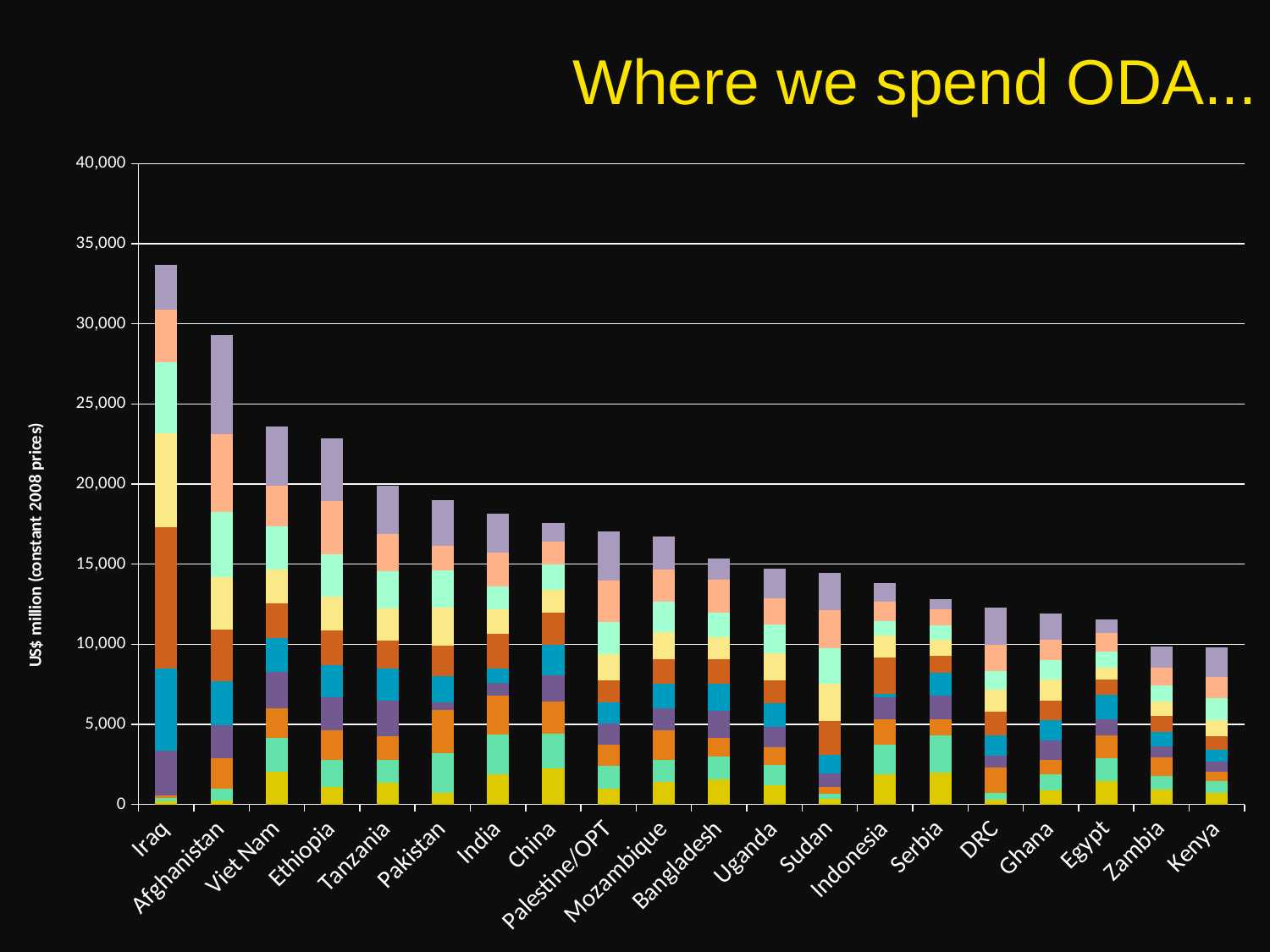
Do the total bar heights rise or fall moving from left to right along the x axis? Fall What is the title of the slide's chart? Where we spend ODA... What kind of chart is shown on the slide? Stacked bar chart Is the total value for Viet Nam greater or less than 20,000? greater Is the total value for Iraq greater or less than 30,000? greater Which has the larger total bar, Ethiopia or Tanzania? Ethiopia Is the total value for China greater or less than 15,000? greater Which has the larger total bar, Afghanistan or Viet Nam? Afghanistan How many countries are shown on the x axis of the chart? 20 Which country has the tallest bar in the chart? Iraq